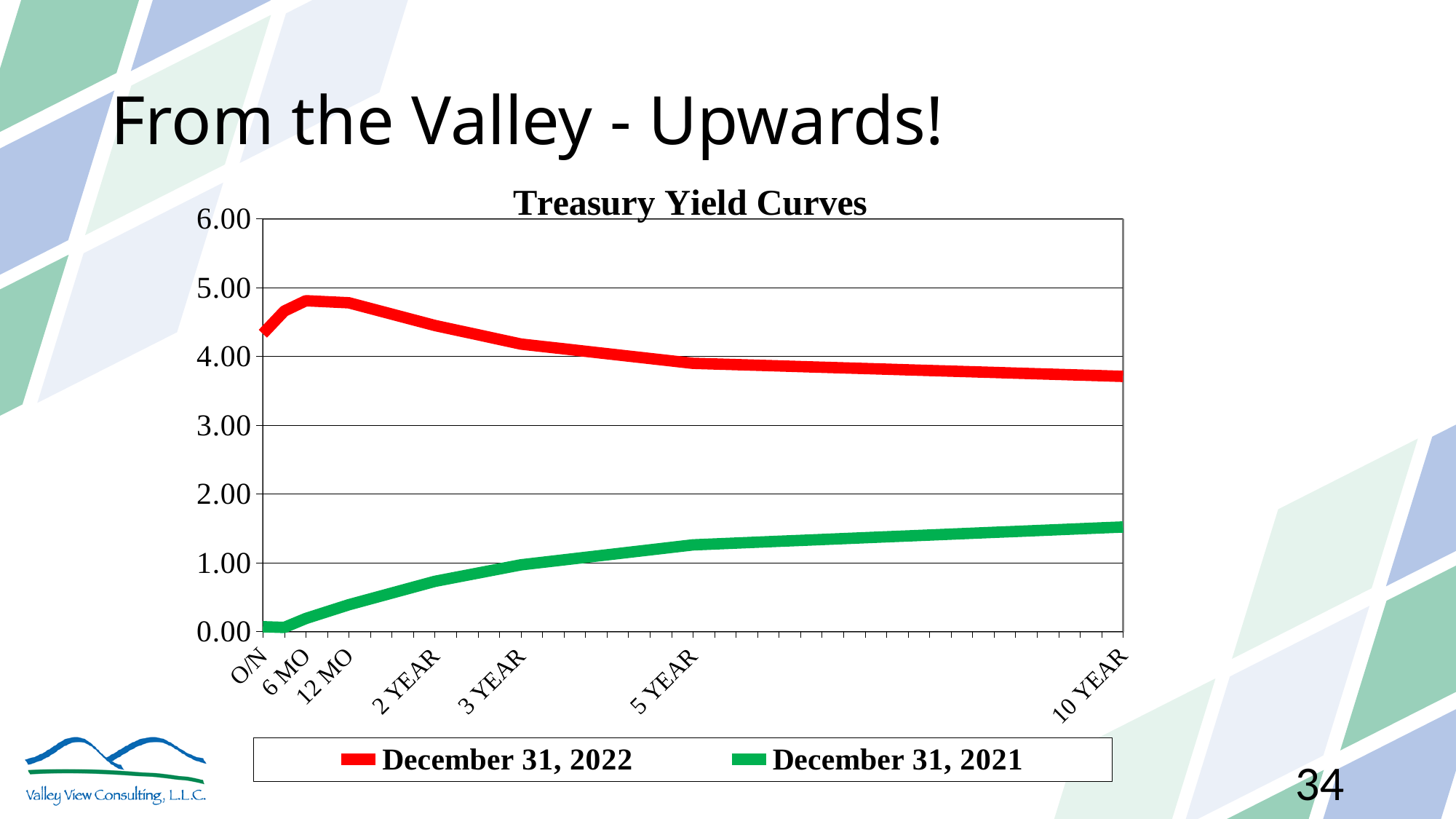
Which series is drawn in green? December 31, 2021 At 10 YEAR, which series has the higher value, December 31, 2022 or December 31, 2021? December 31, 2022 Does the December 31, 2021 series rise or fall from O/N to 10 YEAR? rise What is the title of the chart? Treasury Yield Curves Is the December 31, 2022 value at O/N greater or less than 4.00? greater What kind of chart is shown on the slide? line chart How many series does the legend list? 2 Is the December 31, 2021 value at O/N greater or less than 1.00? less How many maturity labels are shown on the x axis? 7 Is the December 31, 2021 value at 10 YEAR greater or less than 1.00? greater